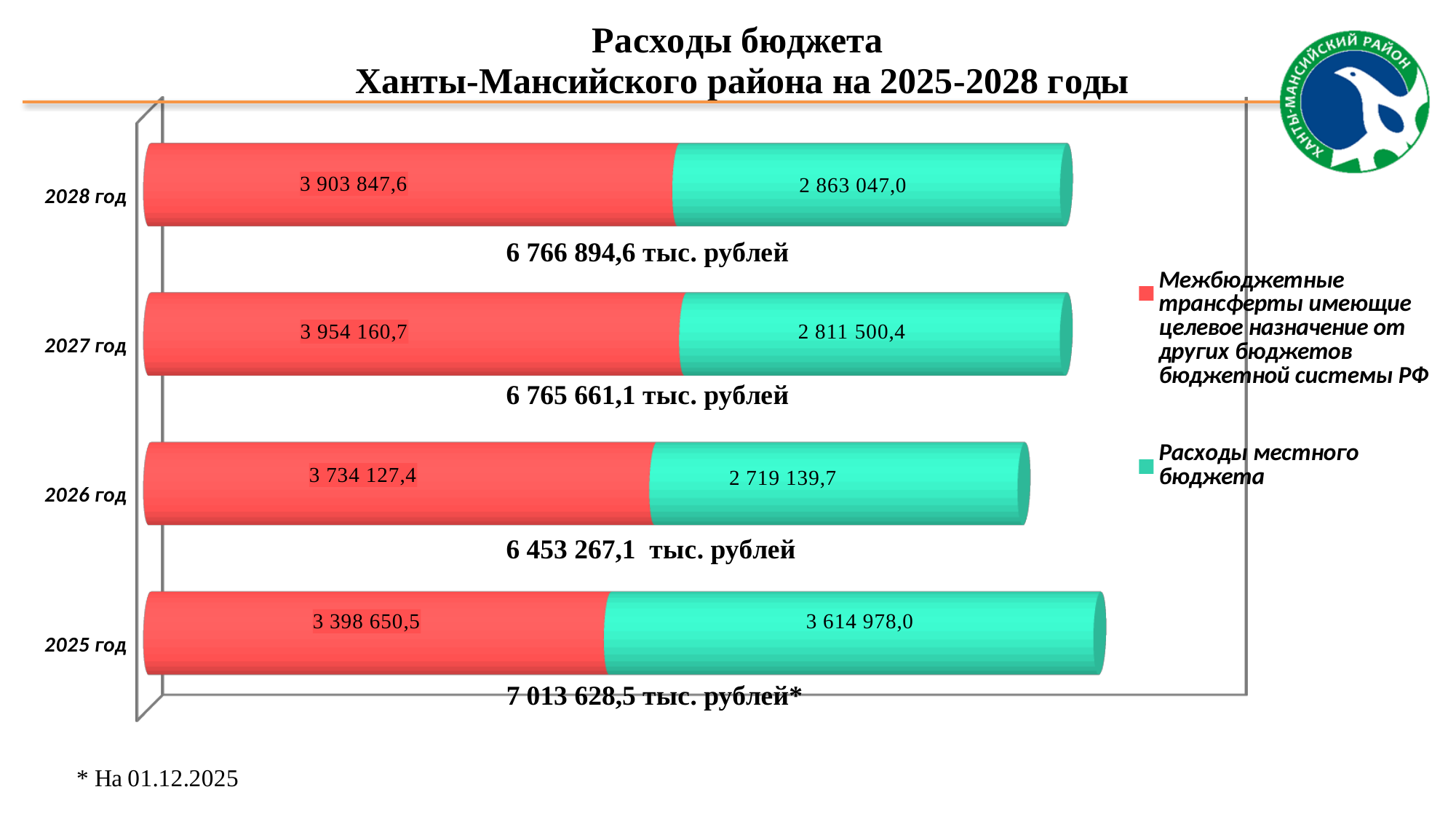
What is the total shown for 2027 год? 6 765 661,1 тыс. рублей Which year has the lowest value for 'Расходы местного бюджета'? 2026 год For 2028 год, which is larger: 'Межбюджетные трансферты' or 'Расходы местного бюджета'? Межбюджетные трансферты How many series does the legend list? 2 What is the value of 'Расходы местного бюджета' for 2026 год? 2 719 139,7 Which year has the highest total budget expenditure? 2025 год What is the difference between 'Расходы местного бюджета' and 'Межбюджетные трансферты' for 2025 год? 216 327,5 What is the value of 'Расходы местного бюджета' for 2025 год? 3 614 978,0 What kind of chart is shown on the slide? Stacked bar chart How many years are shown in the chart? 4 Which year has the highest value for 'Межбюджетные трансферты имеющие целевое назначение от других бюджетов бюджетной системы РФ'? 2027 год What is the value of 'Межбюджетные трансферты имеющие целевое назначение от других бюджетов бюджетной системы РФ' for 2028 год? 3 903 847,6